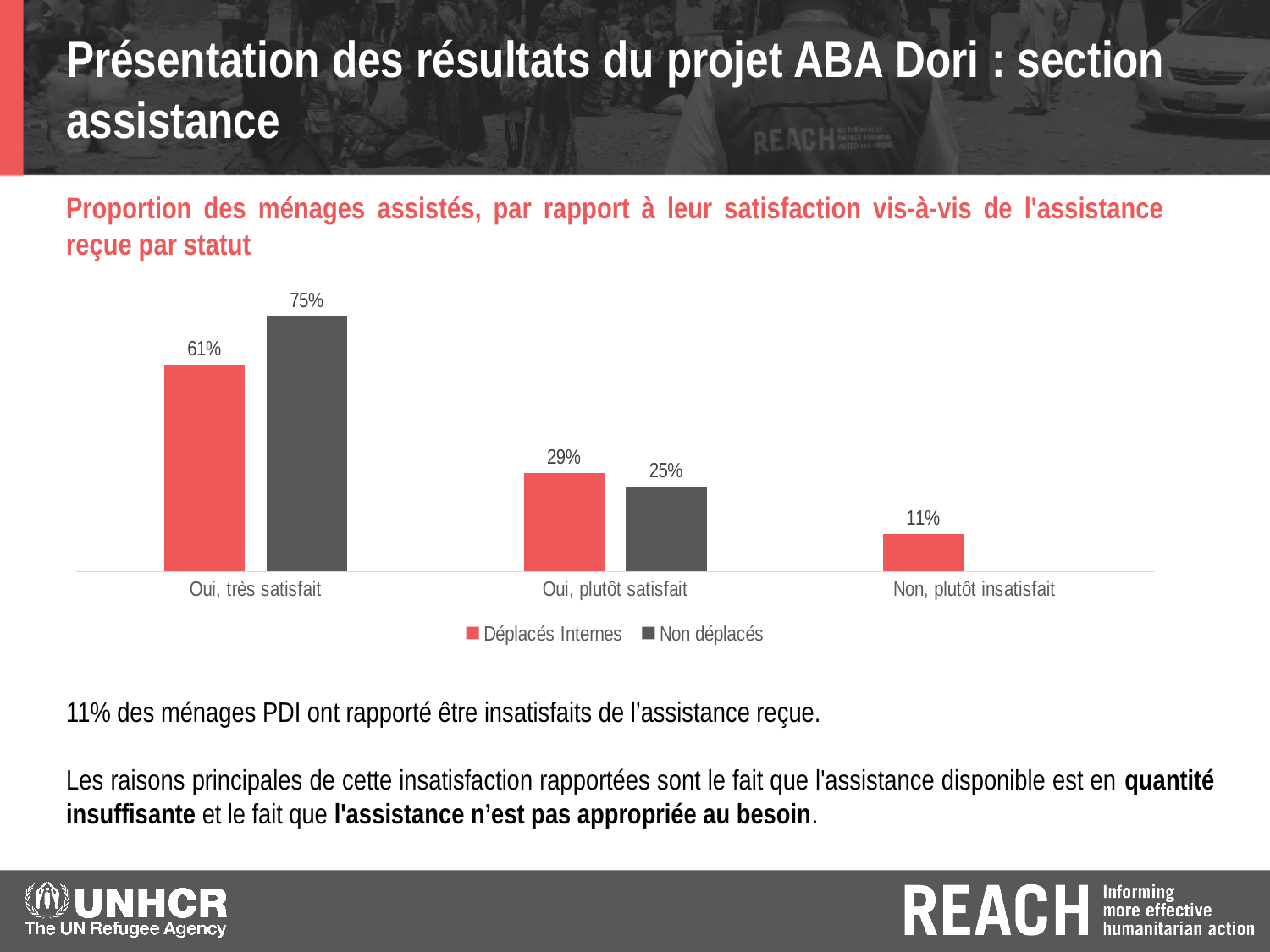
What kind of chart is shown on the slide? Bar chart How many series does the legend list? 2 In the 'Oui, plutôt satisfait' category, which series has the larger value, Déplacés Internes or Non déplacés? Déplacés Internes What is the value for Déplacés Internes in the 'Non, plutôt insatisfait' category? 11% What is the value for Non déplacés in the 'Oui, très satisfait' category? 75% What is the value for Déplacés Internes in the 'Oui, très satisfait' category? 61% What is the value for Déplacés Internes in the 'Oui, plutôt satisfait' category? 29% How many categories are shown on the x axis? 3 Which category has the lowest value for Déplacés Internes? Non, plutôt insatisfait Which category has the highest value for Non déplacés? Oui, très satisfait What is the value for Non déplacés in the 'Oui, plutôt satisfait' category? 25% What is the difference between Non déplacés and Déplacés Internes in the 'Oui, très satisfait' category? 14%